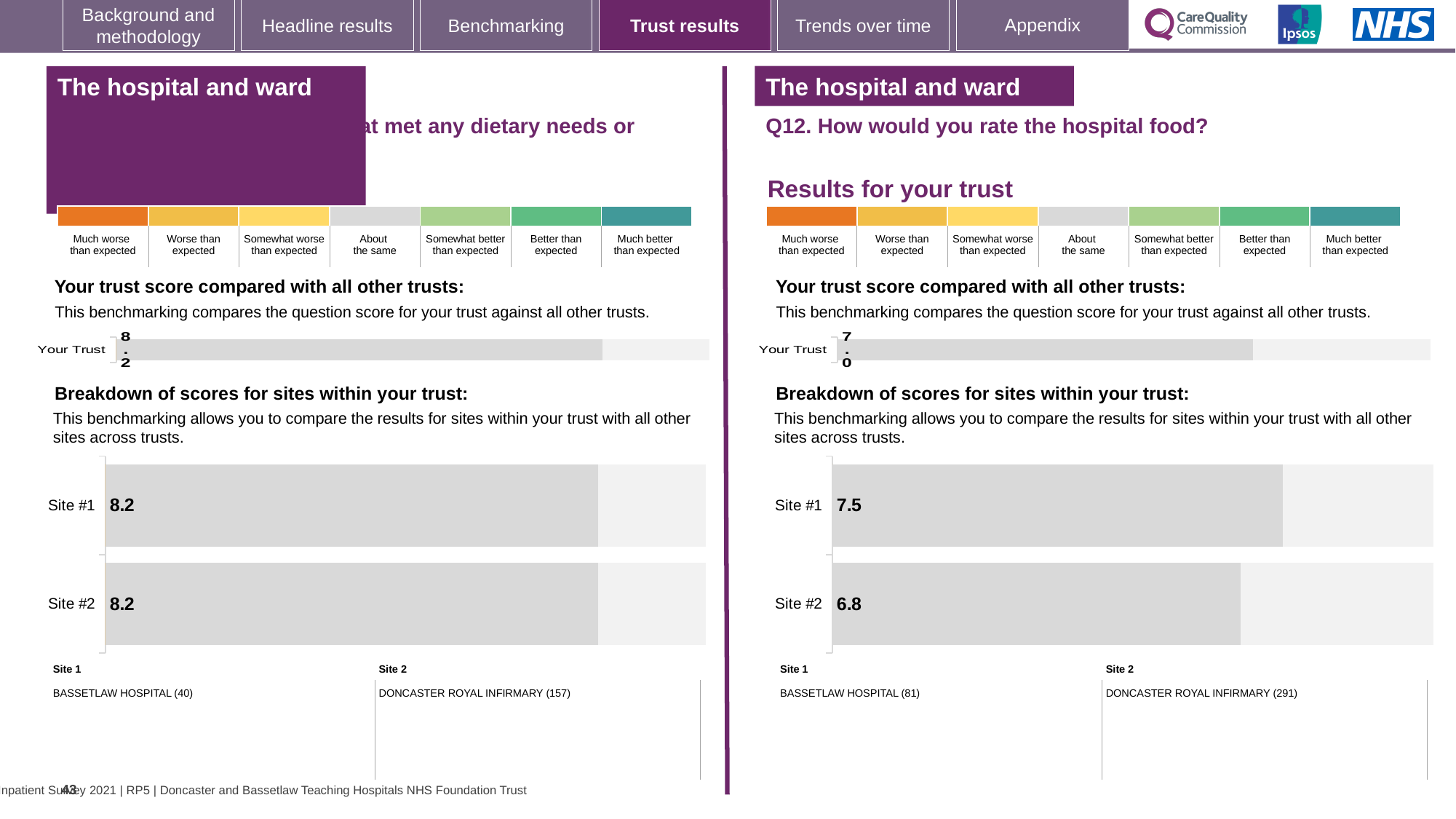
On the right-hand chart for Q12 (How would you rate the hospital food?), what is the score for Site #2? 6.8 What type of chart is used for the site breakdown on the right-hand side (Q12)? Bar chart On the right-hand chart for Q12, which site has the lowest score? Site #2 On the right-hand side (Q12), which hospital is listed as Site 2? DONCASTER ROYAL INFIRMARY (291) On the right-hand chart for Q12 (How would you rate the hospital food?), what is the score for Site #1? 7.5 On the left-hand site breakdown chart, what is the score for Site #1? 8.2 How many sites are shown in the site breakdown chart on the right-hand side (Q12)? 2 On the left-hand site breakdown chart, what is the score for Site #2? 8.2 On the right-hand chart for Q12, what is the difference between the Site #1 and Site #2 scores? 0.7 On the left-hand side of the slide, what is the 'Your Trust' score shown in the trust benchmarking bar? 8.2 On the right-hand side of the slide (Q12), what is the 'Your Trust' score shown in the trust benchmarking bar? 7.0 On the right-hand chart for Q12, which site has the higher score, Site #1 or Site #2? Site #1